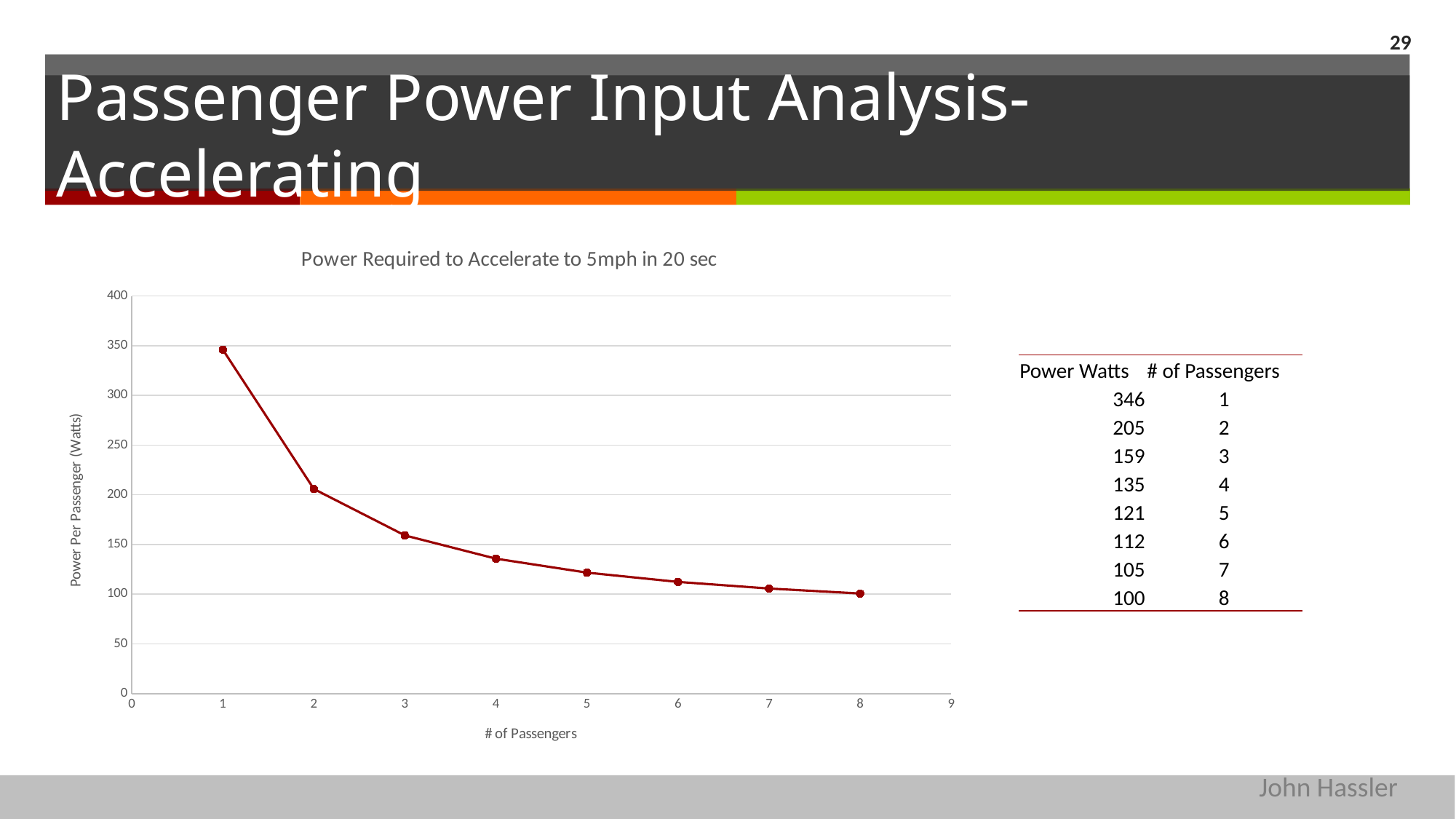
Does the power per passenger rise or fall as the number of passengers increases? fall What is the power per passenger for 4 passengers? 135 What kind of chart is shown on the slide? line chart What is the difference in power per passenger between 1 passenger and 2 passengers? 141 Which number of passengers has the lowest power per passenger? 8 What is the power per passenger for 8 passengers? 100 What is the title of the chart? Power Required to Accelerate to 5mph in 20 sec How many data points are plotted on the chart? 8 Which has a larger power per passenger, 3 passengers or 6 passengers? 3 passengers Is the value for 2 passengers greater or less than 200? greater What is the power per passenger for 1 passenger? 346 Which number of passengers has the highest power per passenger? 1